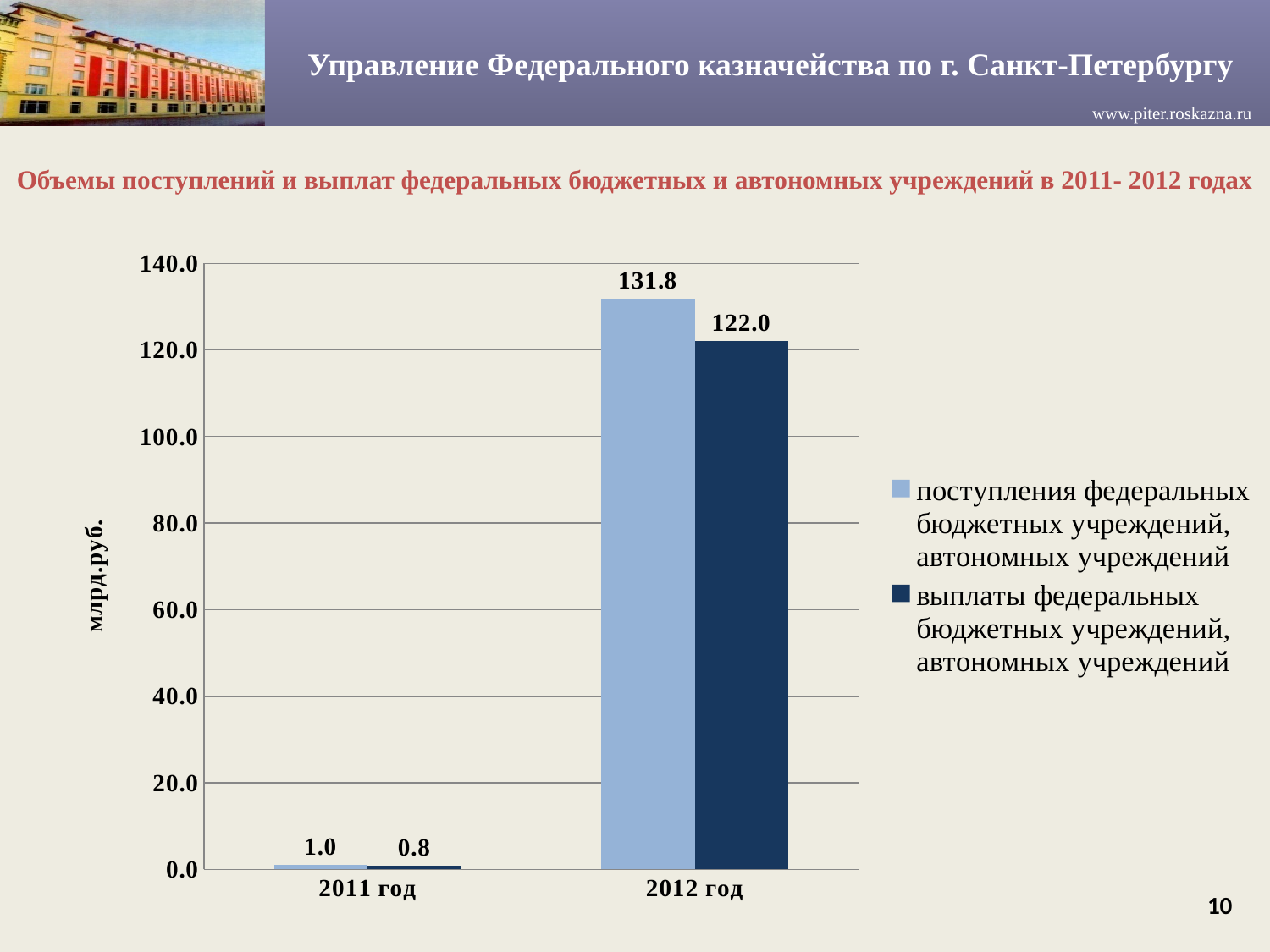
What is the value of выплаты федеральных бюджетных учреждений, автономных учреждений for 2012 год? 122.0 What unit is shown on the vertical axis label? млрд.руб. How many year categories are shown on the x axis? 2 Which year has the lowest value for выплаты федеральных бюджетных учреждений, автономных учреждений? 2011 год Which year has the highest value for поступления федеральных бюджетных учреждений, автономных учреждений? 2012 год What is the difference between поступления and выплаты in 2012 год? 9.8 What is the value of поступления федеральных бюджетных учреждений, автономных учреждений for 2011 год? 1.0 In 2012 год, which is larger: поступления or выплаты? поступления How many series does the legend list? 2 What is the value of выплаты федеральных бюджетных учреждений, автономных учреждений for 2011 год? 0.8 What kind of chart is shown on the slide? bar chart What is the value of поступления федеральных бюджетных учреждений, автономных учреждений for 2012 год? 131.8